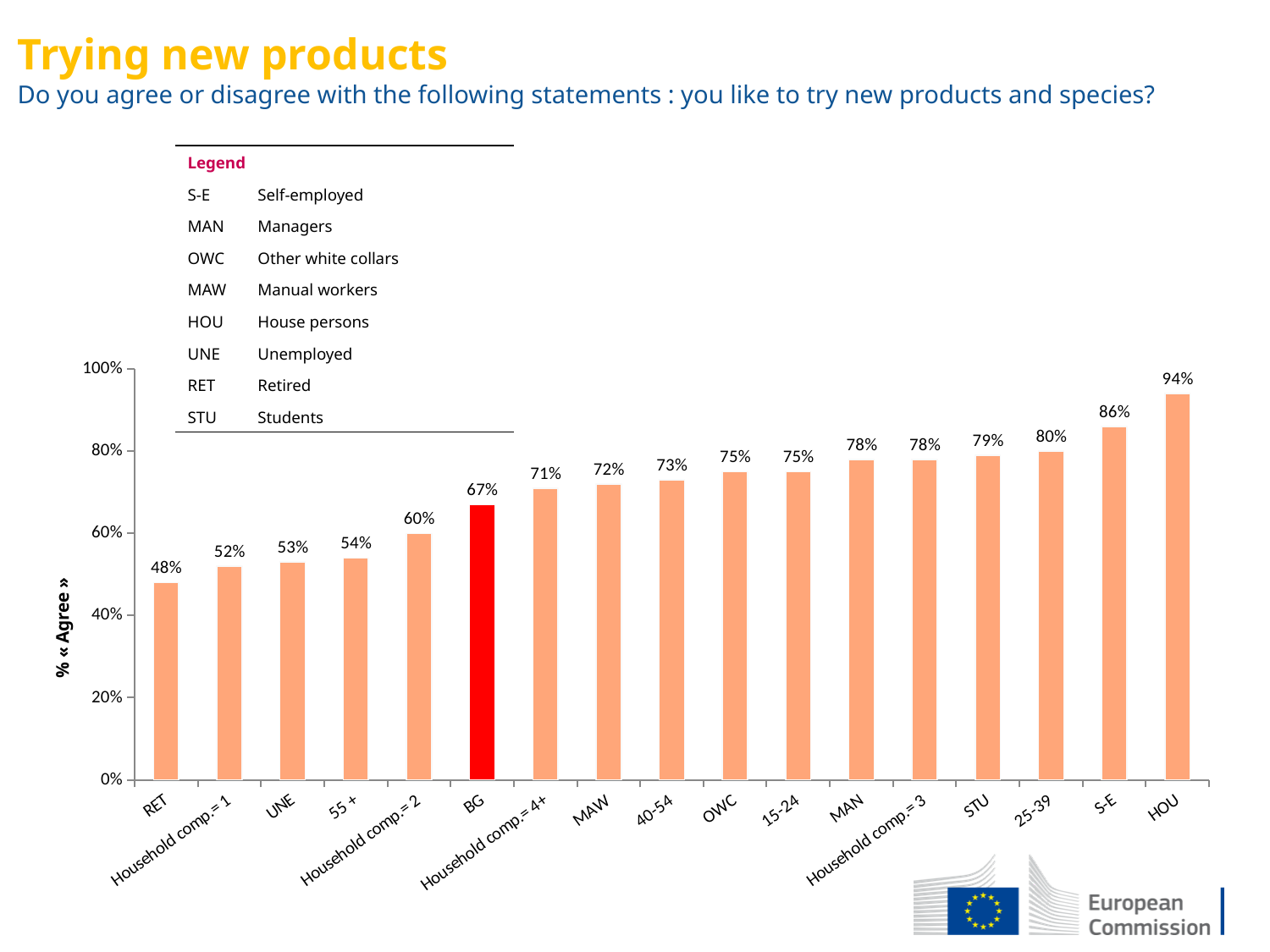
What is the value for BG? 67% What is the difference between the values for HOU and RET? 46% What is the value for Household comp.= 2? 60% What is the difference between the values for S-E and BG? 19% Which bar is highlighted in red? BG What is the value for STU? 79% Which category has the lowest value? RET How many bars are shown in the chart? 17 Which is larger, the value for MAW or the value for UNE? MAW Which category has the highest value? HOU Is the value for 25-39 greater or less than 60%? greater What kind of chart is shown on the slide? Bar chart